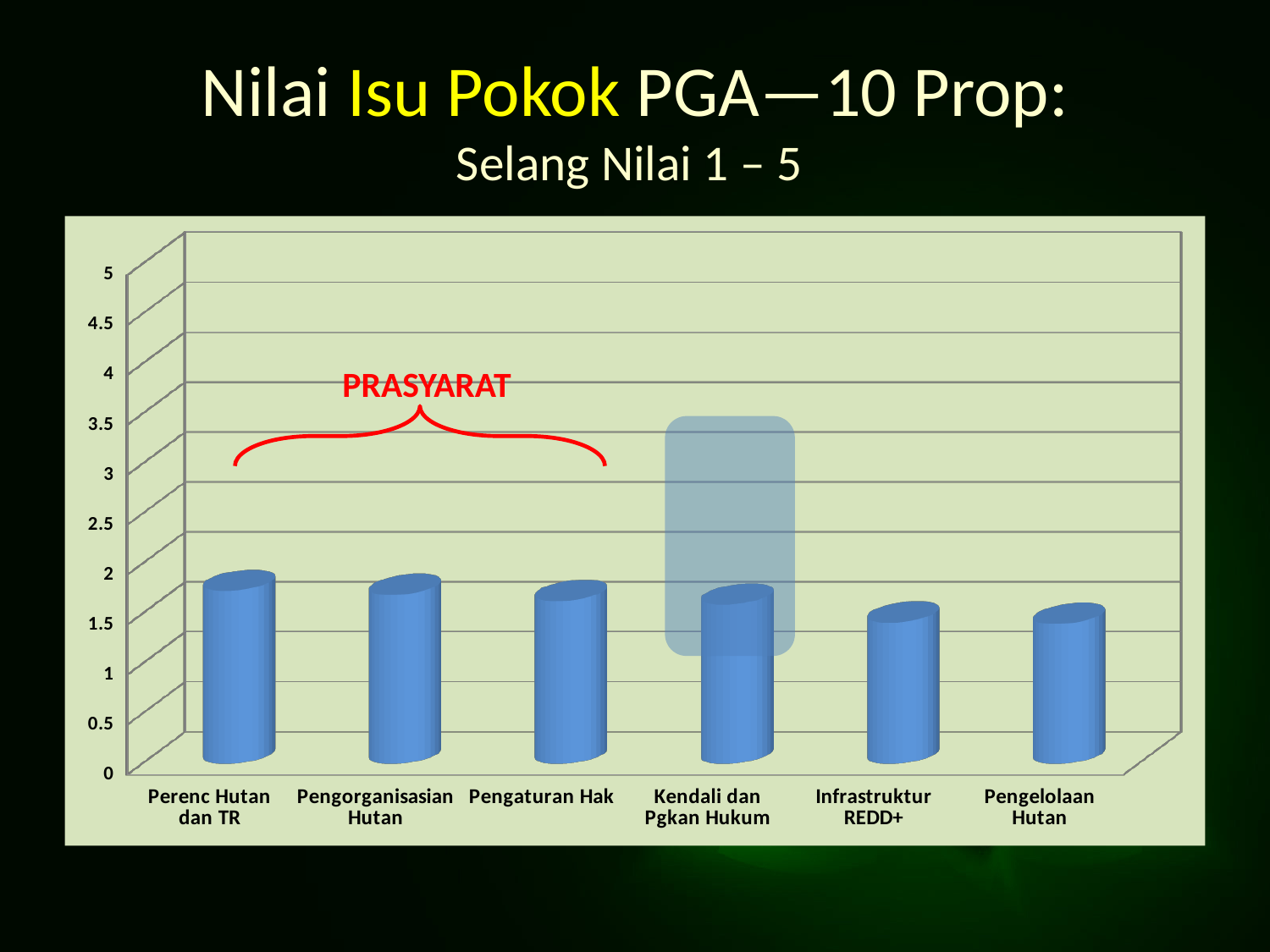
Which is larger, the value for Perenc Hutan dan TR or the value for Pengelolaan Hutan? Perenc Hutan dan TR Is the value for Perenc Hutan dan TR greater or less than 1.5? greater Which category has the highest value? Perenc Hutan dan TR What is the highest value shown on the vertical axis? 5 Is the value for Kendali dan Pgkan Hukum greater or less than 2? less What kind of chart is shown on the slide? bar chart Do the values generally rise or fall from left to right across the categories? fall Is the value for Pengelolaan Hutan greater or less than 2? less How many categories are plotted on the chart? 6 What red annotation label is written above the bracket spanning the first three categories? PRASYARAT